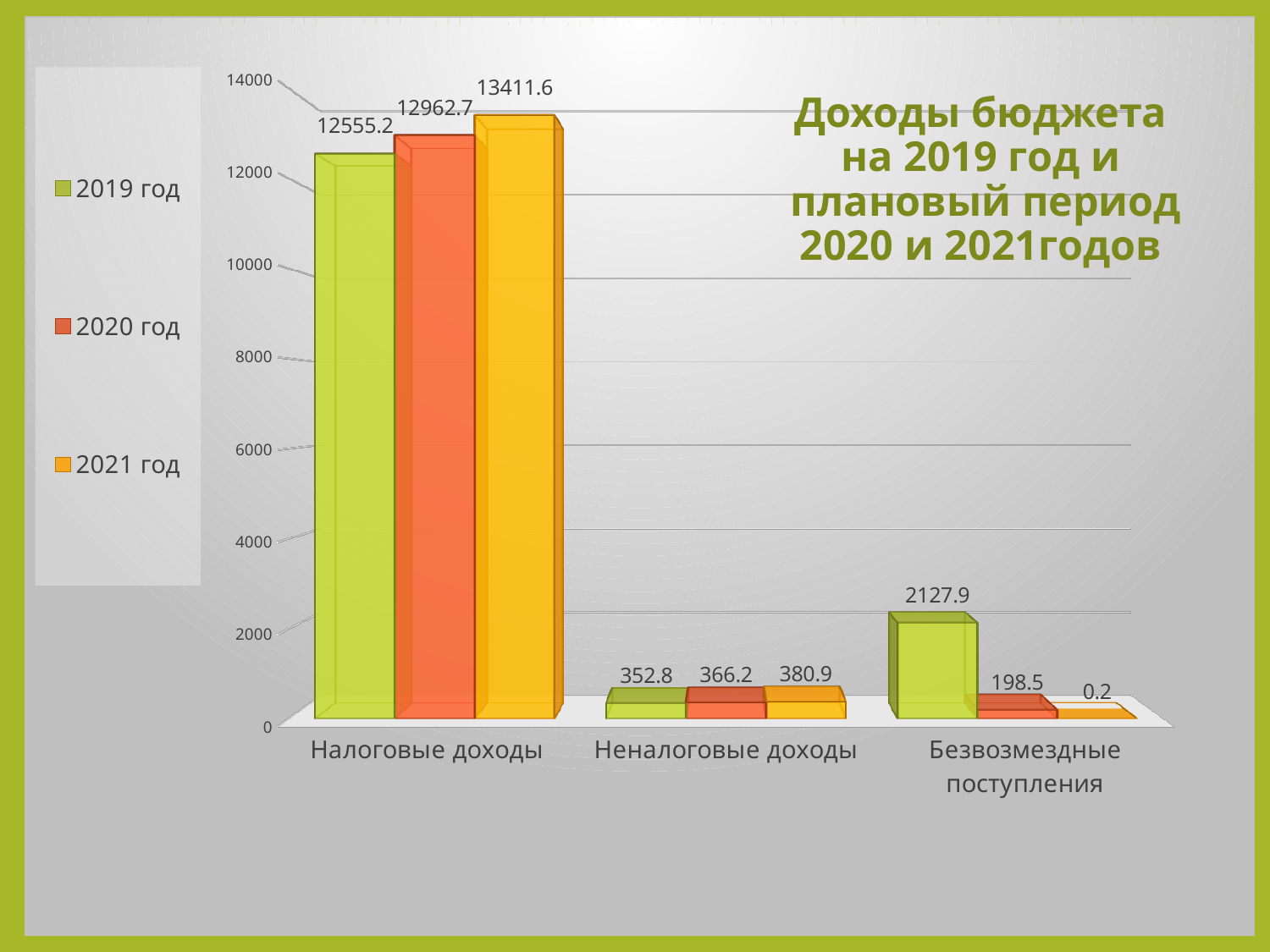
What is the value for Безвозмездные поступления in the 2021 год series? 0.2 What kind of chart is shown on the slide? Bar chart What is the difference between the 2019 год and 2020 год values for Безвозмездные поступления? 1929.4 How many categories are shown on the x axis? 3 Which category has the highest value in the 2021 год series? Налоговые доходы How many series does the legend list? 3 What is the title of the chart? Доходы бюджета на 2019 год и плановый период 2020 и 2021годов What is the value for Налоговые доходы in the 2019 год series? 12555.2 What is the value for Неналоговые доходы in the 2020 год series? 366.2 Which is larger for Неналоговые доходы: the 2019 год value or the 2021 год value? 2021 год What is the difference between the 2021 год and 2019 год values for Налоговые доходы? 856.4 Which category has the lowest value in the 2019 год series? Неналоговые доходы